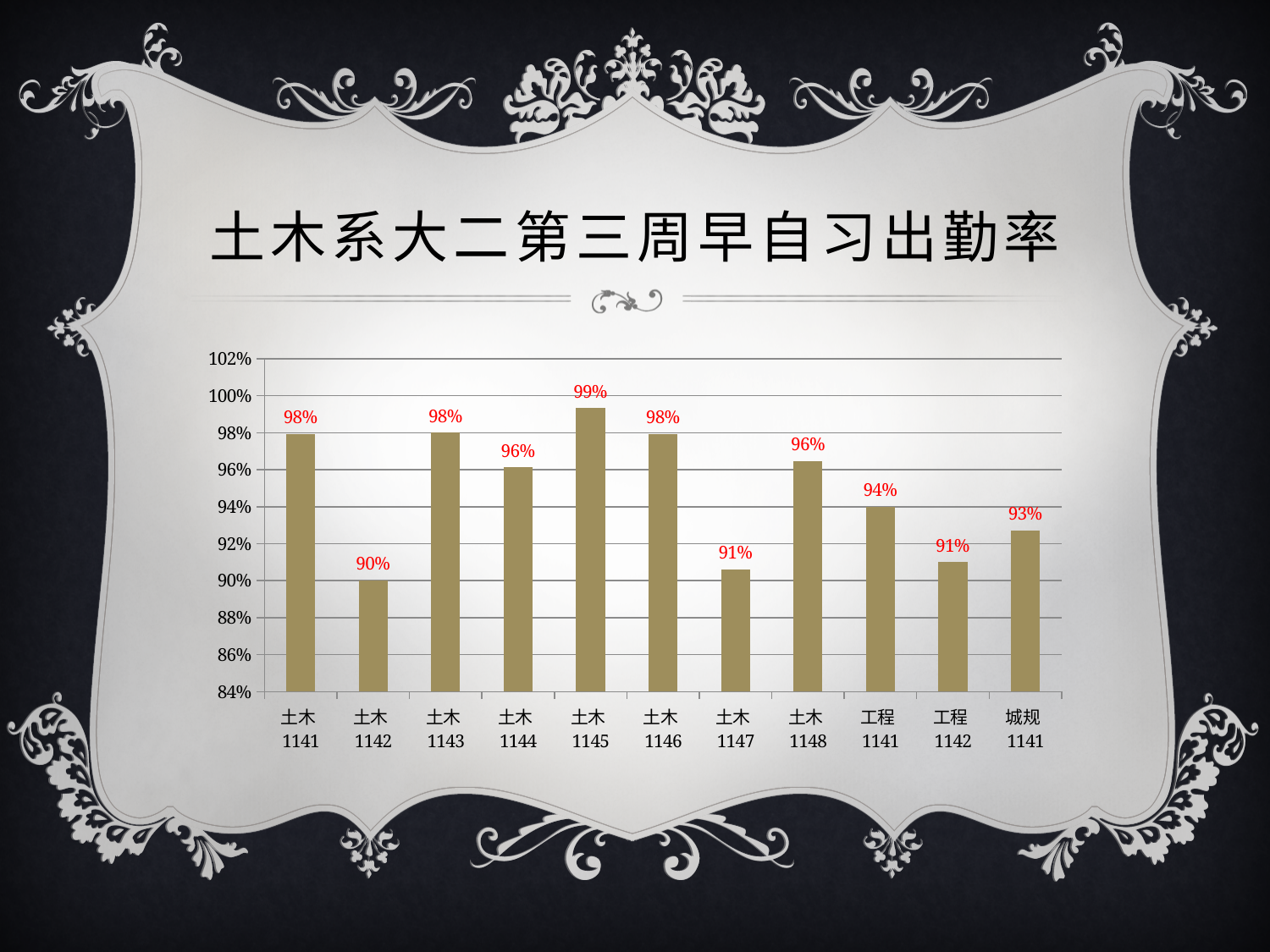
Is the value for 土木1147 greater or less than 92%? less How many classes are shown on the chart? 11 Which has a higher attendance rate, 工程1141 or 城规1141? 工程1141 What is the attendance rate for 工程1142? 91% Which class has the lowest attendance rate? 土木1142 What is the title of the slide? 土木系大二第三周早自习出勤率 What is the attendance rate for 土木1145? 99% What kind of chart is shown on the slide? bar chart Is the value for 工程1141 greater or less than 92%? greater What is the difference between the attendance rates of 土木1145 and 土木1142? 9% What is the attendance rate for 城规1141? 93% Which class has the highest attendance rate? 土木1145